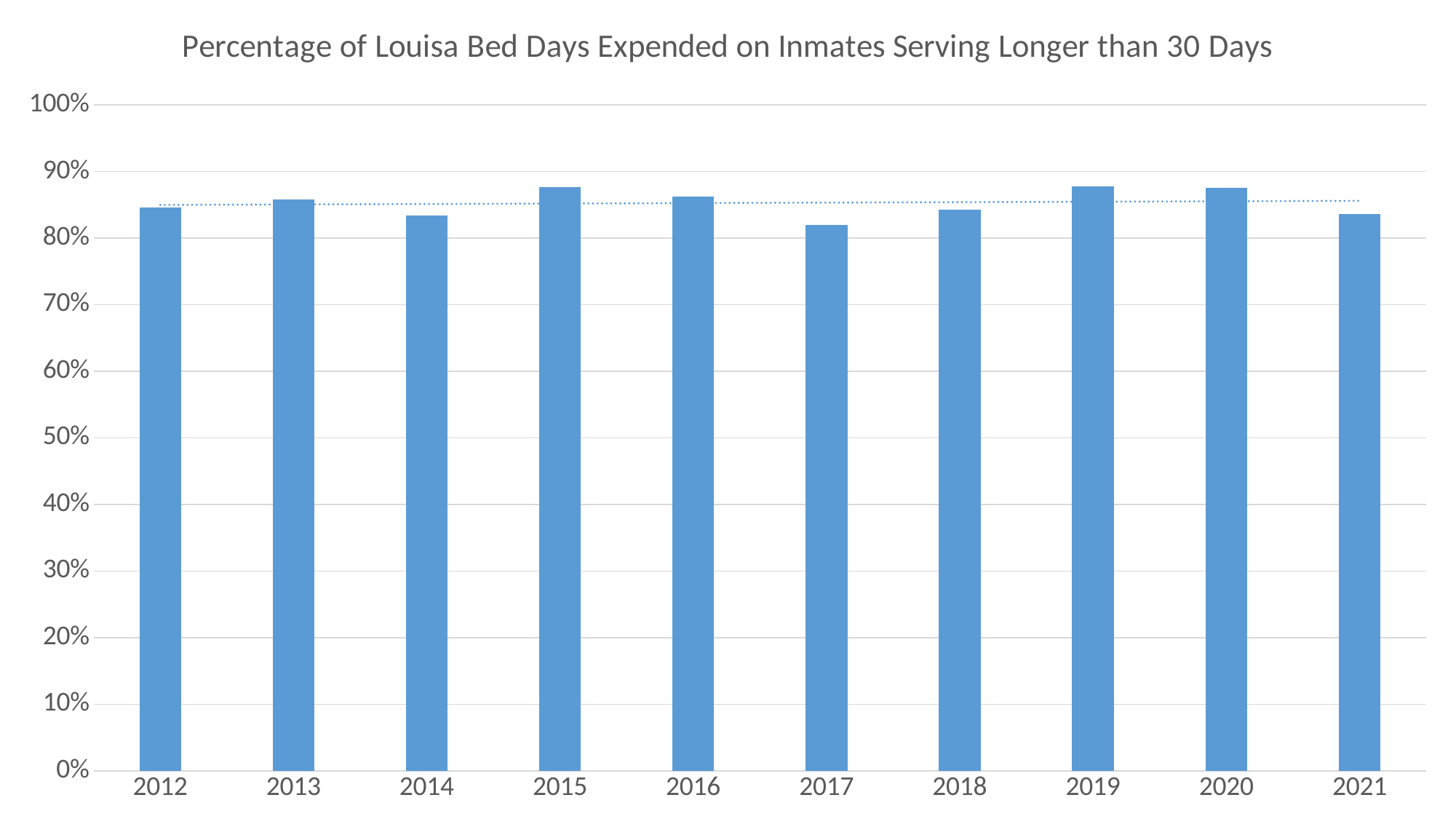
Which year has the larger value, 2015 or 2017? 2015 What kind of chart is shown on the slide? bar chart Is the value for 2017 greater or less than 90%? less Is the value for 2019 greater or less than 80%? greater What is the title of the chart? Percentage of Louisa Bed Days Expended on Inmates Serving Longer than 30 Days Which year has the larger value, 2016 or 2021? 2016 Is the value for 2015 greater or less than 90%? less Which year has the larger value, 2014 or 2015? 2015 What colour are the bars in the chart? blue Which year has the lowest percentage of bed days expended on inmates serving longer than 30 days? 2017 How many years are plotted on the x axis? 10